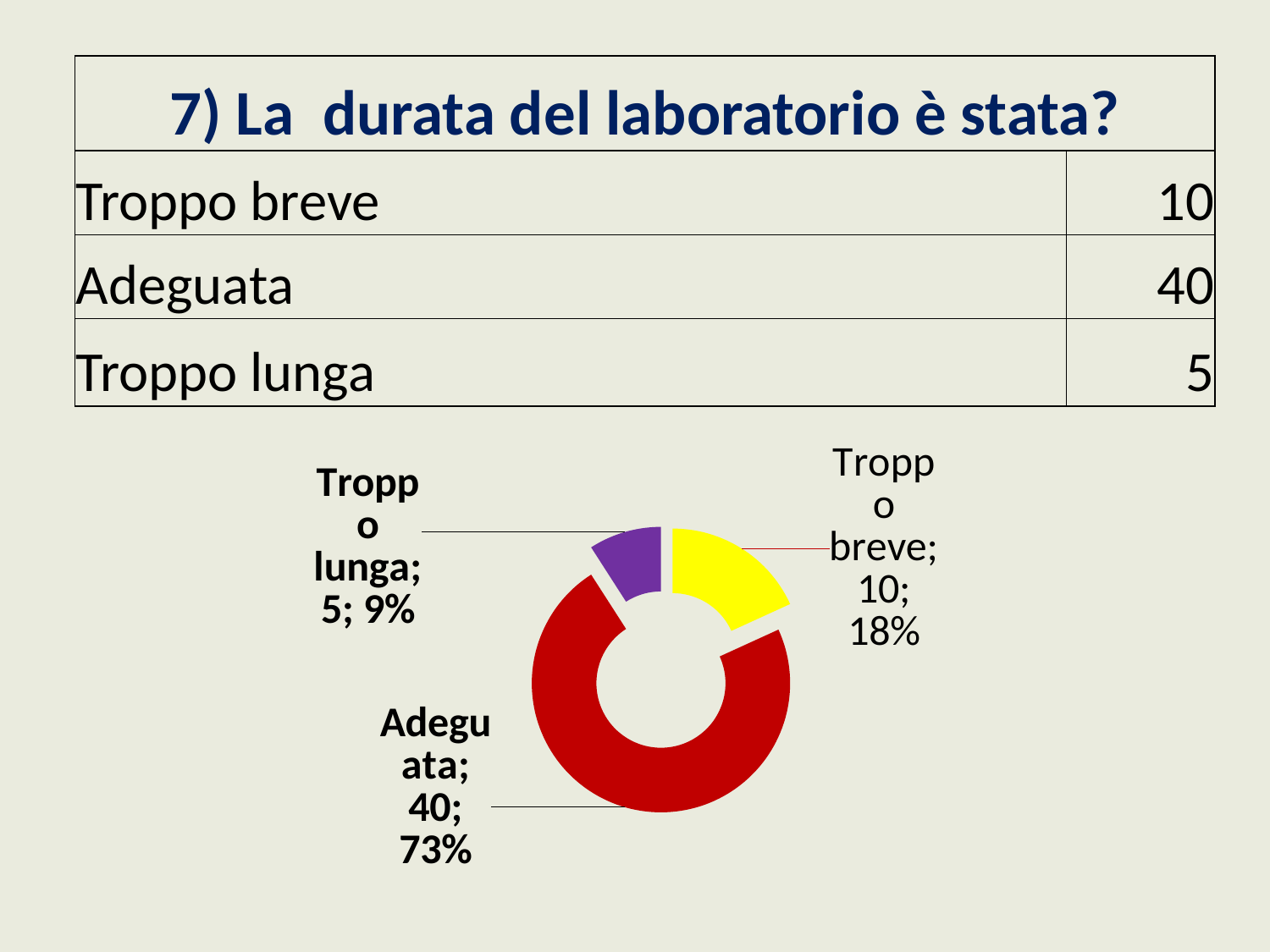
What is the value for Troppo breve in the chart? 10 What percentage share does Troppo lunga have in the chart? 9% Which category has the smallest slice in the chart? Troppo lunga What kind of chart is shown on the slide? Doughnut chart What is the value for Troppo lunga in the chart? 5 How many categories are shown in the chart? 3 What is the difference between the values for Adeguata and Troppo breve? 30 Which category has the largest slice in the chart? Adeguata Which is larger, the value for Troppo breve or the value for Troppo lunga? Troppo breve What percentage share does Adeguata have in the chart? 73% What percentage share does Troppo breve have in the chart? 18% What is the value for Adeguata in the chart? 40